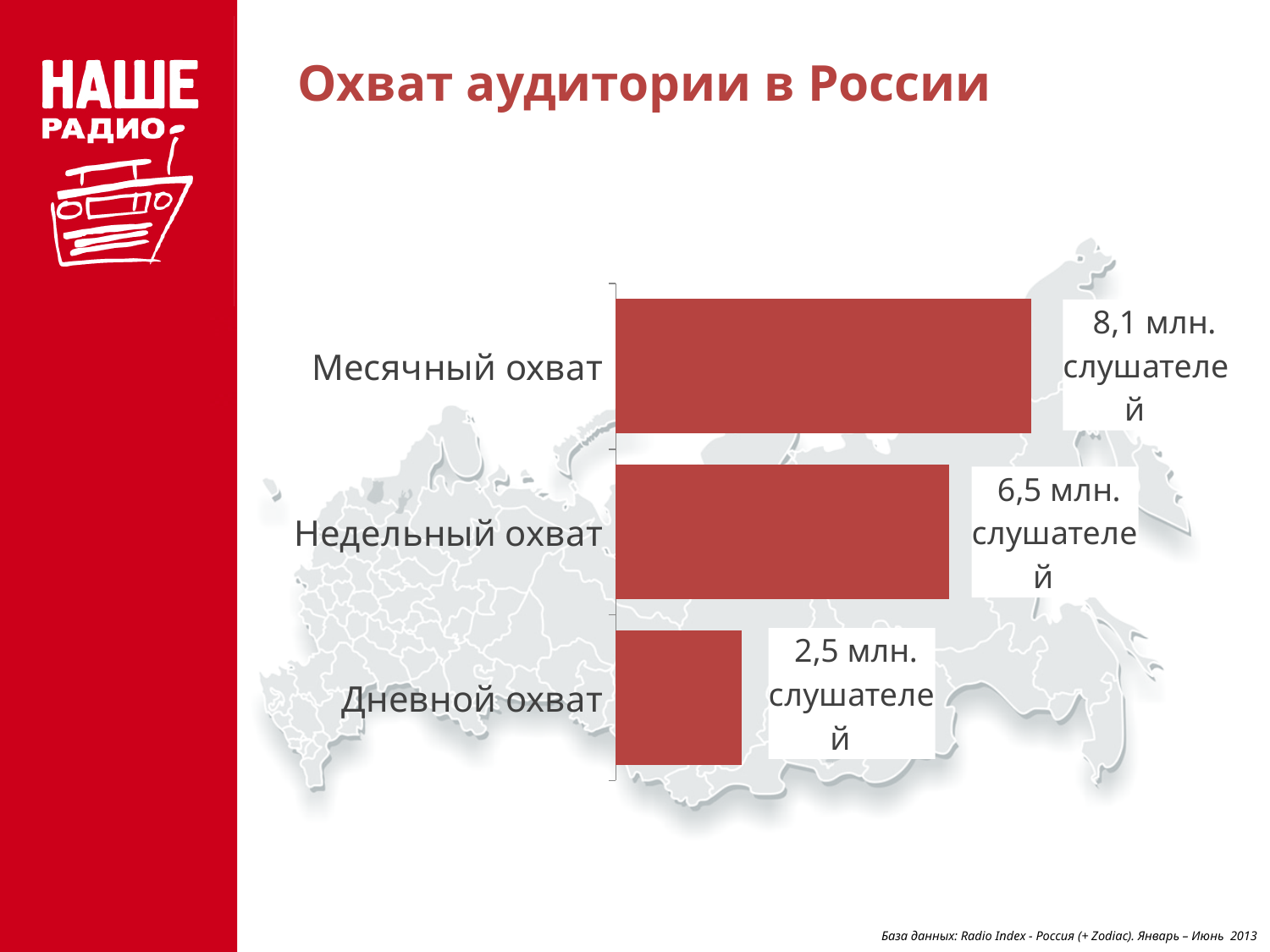
What is the value shown for Месячный охват? 8,1 млн. слушателей What is the title of the slide containing the chart? Охват аудитории в России Which category has the lowest value? Дневной охват What is the difference between Месячный охват and Дневной охват? 5,6 млн. What is the value shown for Недельный охват? 6,5 млн. слушателей Which is larger, Недельный охват or Дневной охват? Недельный охват How many categories are shown in the chart? 3 Which category has the highest value? Месячный охват What is the difference between Недельный охват and Дневной охват? 4 млн. What kind of chart is shown on the slide? Bar chart What is the difference between Месячный охват and Недельный охват? 1,6 млн. What is the value shown for Дневной охват? 2,5 млн. слушателей